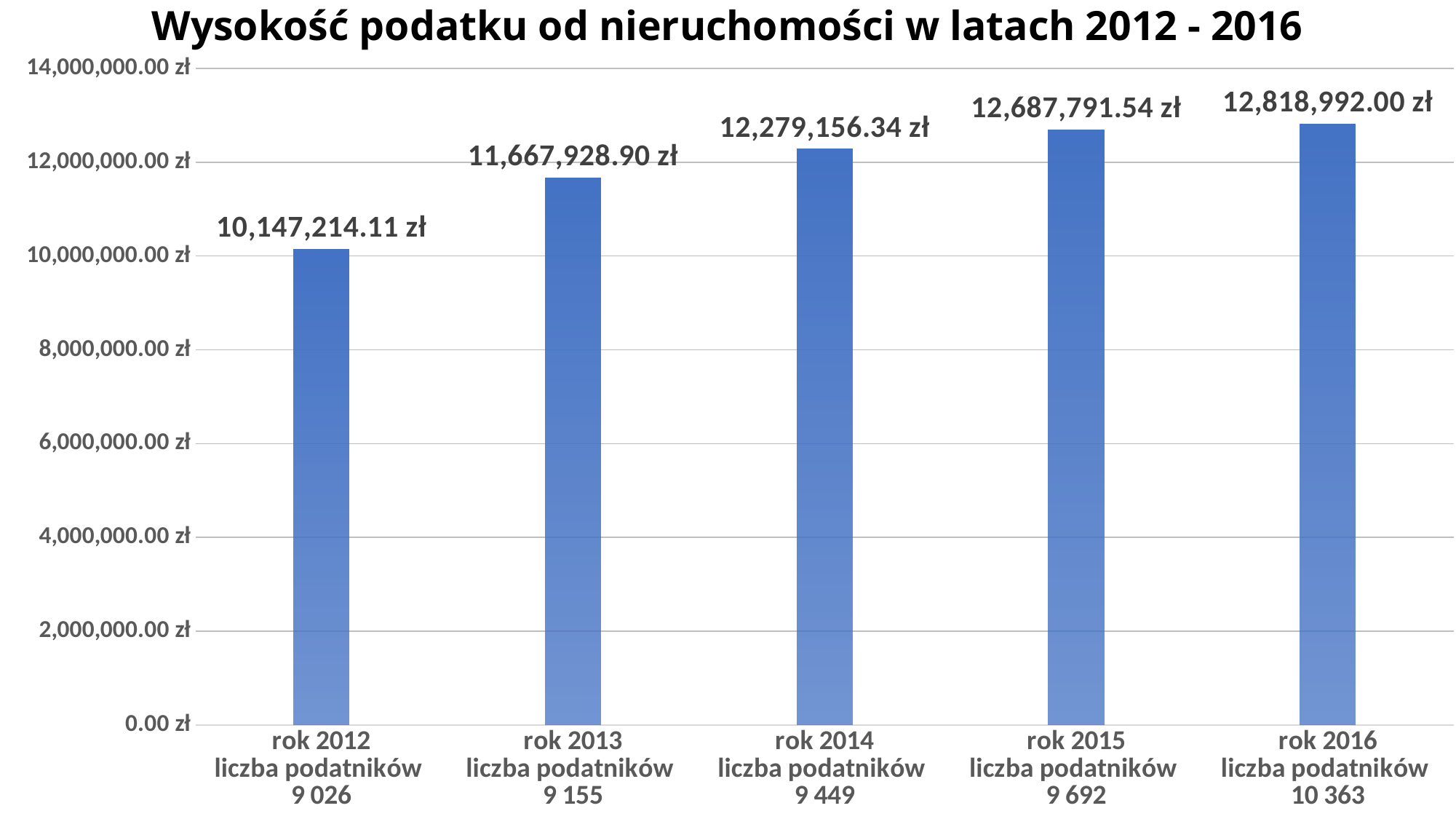
What is the difference between the property tax amounts for rok 2016 and rok 2015? 131,200.46 zł Which year has the highest property tax amount? rok 2016 What is the property tax amount shown for rok 2012? 10,147,214.11 zł Is the value for rok 2012 greater or less than 10,000,000.00 zł? greater Do the property tax amounts rise or fall from rok 2012 to rok 2016? rise What kind of chart is shown on the slide? bar chart What is the difference between the property tax amounts for rok 2013 and rok 2012? 1,520,714.79 zł Which is larger, the property tax amount for rok 2013 or for rok 2014? rok 2014 What is the property tax amount shown for rok 2016? 12,818,992.00 zł What is the property tax amount shown for rok 2014? 12,279,156.34 zł How many years (bars) are shown in the chart? 5 Which year has the lowest property tax amount? rok 2012